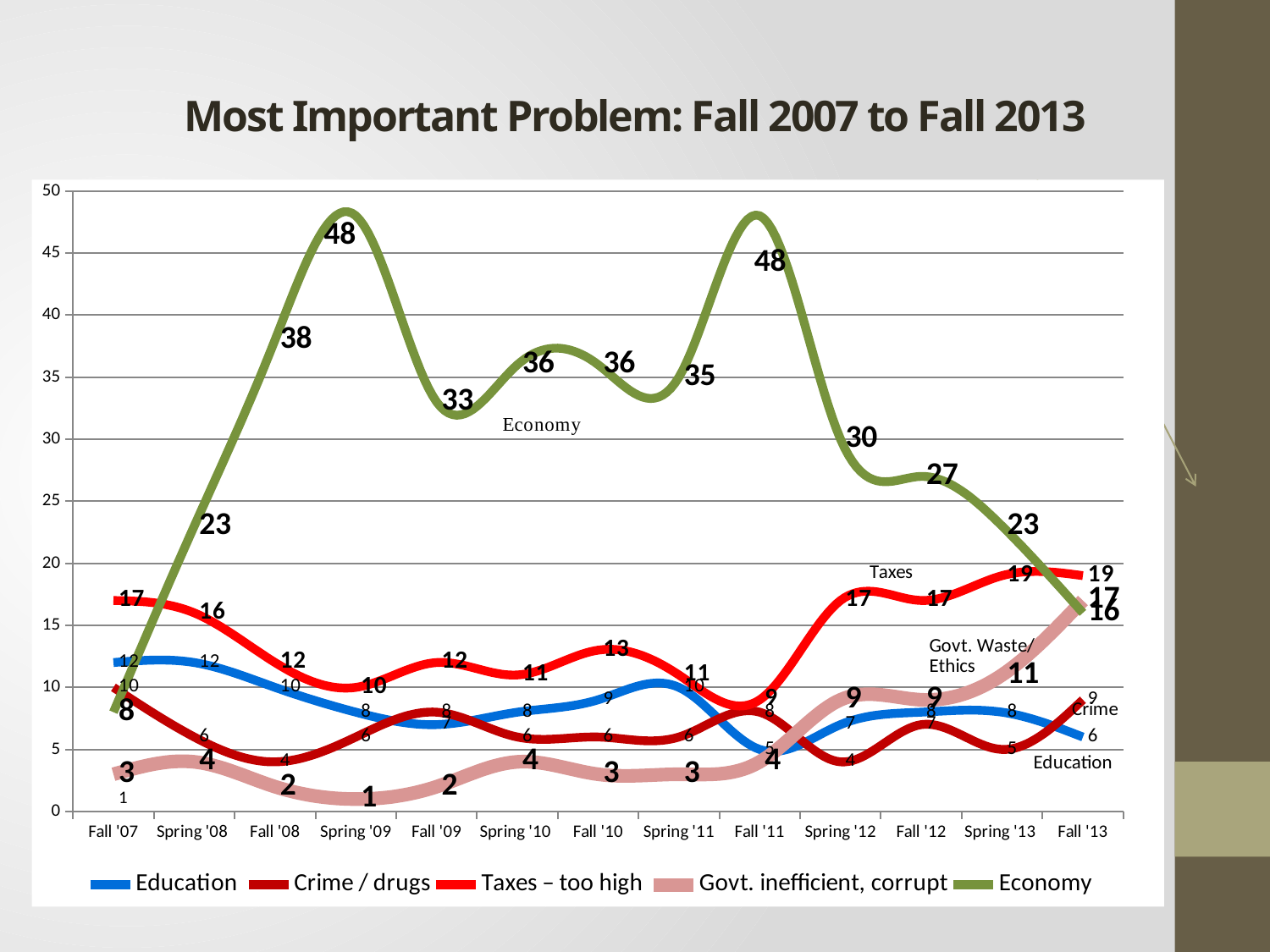
What kind of chart is shown on the slide? line chart Does the Economy series rise or fall from Fall '11 to Fall '13? fall In Fall '13, which is larger: Taxes – too high or Economy? Taxes – too high What is the value for Taxes – too high in Fall '13? 19 How many time points are shown along the x axis? 13 What is the value for Economy in Fall '13? 16 What is the highest value reached by the Economy series? 48 What is the value for Economy in Spring '09? 48 What is the value for Govt. inefficient, corrupt in Spring '09? 1 How many series does the legend list? 5 What is the difference between the Economy values in Fall '08 and Fall '09? 5 Which series is drawn in green? Economy